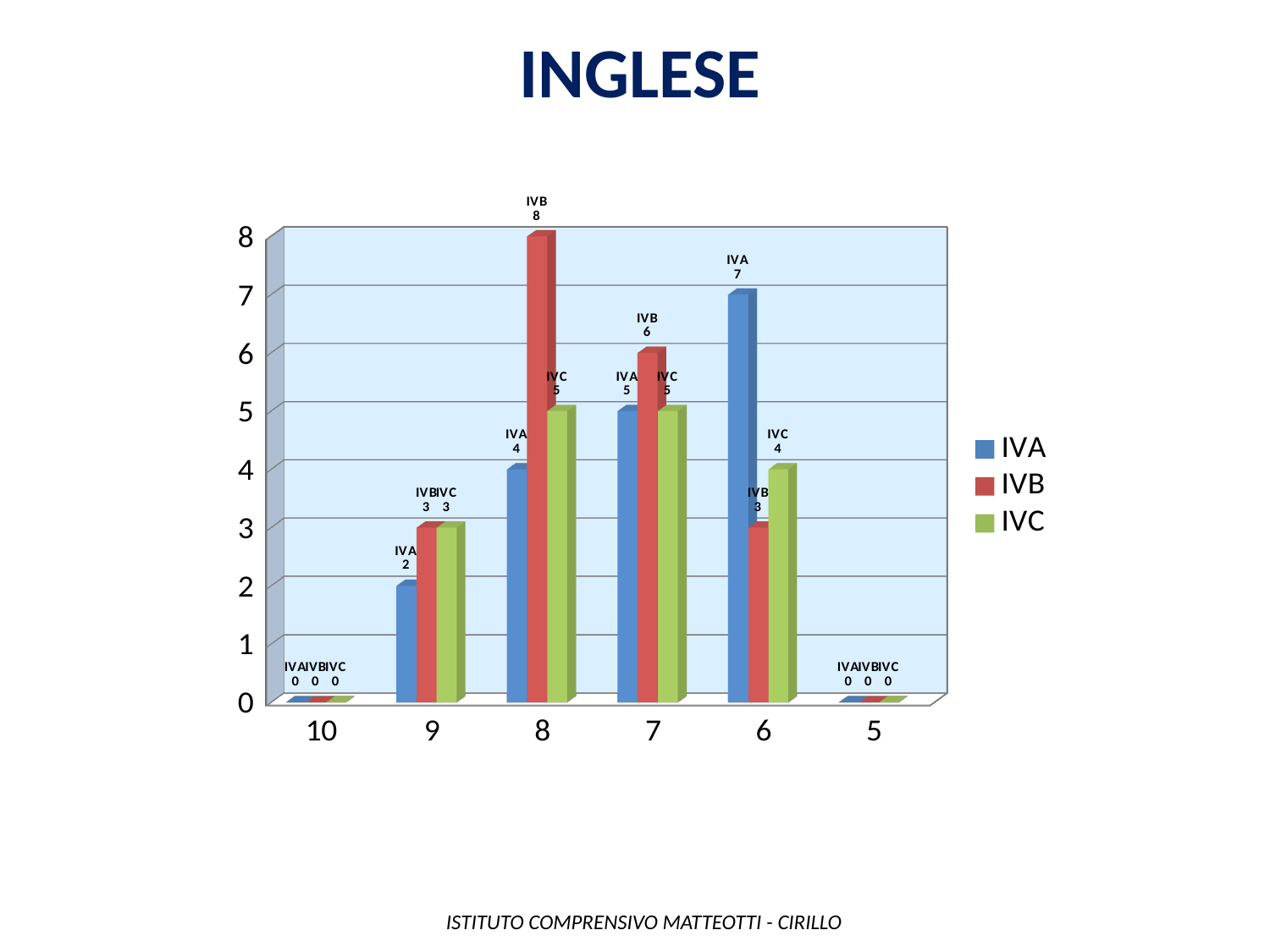
What kind of chart is shown on the slide? bar chart What is the difference between the IVB and IVA values at category 8? 4 What is the value for IVA at category 6? 7 What is the value for IVB at category 8? 8 Which series has the lowest value at category 6? IVB How many series does the legend list? 3 How many categories are shown on the x axis? 6 At category 7, which is larger: the IVB value or the IVC value? IVB What is the title of the chart? INGLESE Which category has the highest IVA value? 6 What is the value for IVC at category 9? 3 What is the total of the IVA, IVB and IVC values at category 9? 8